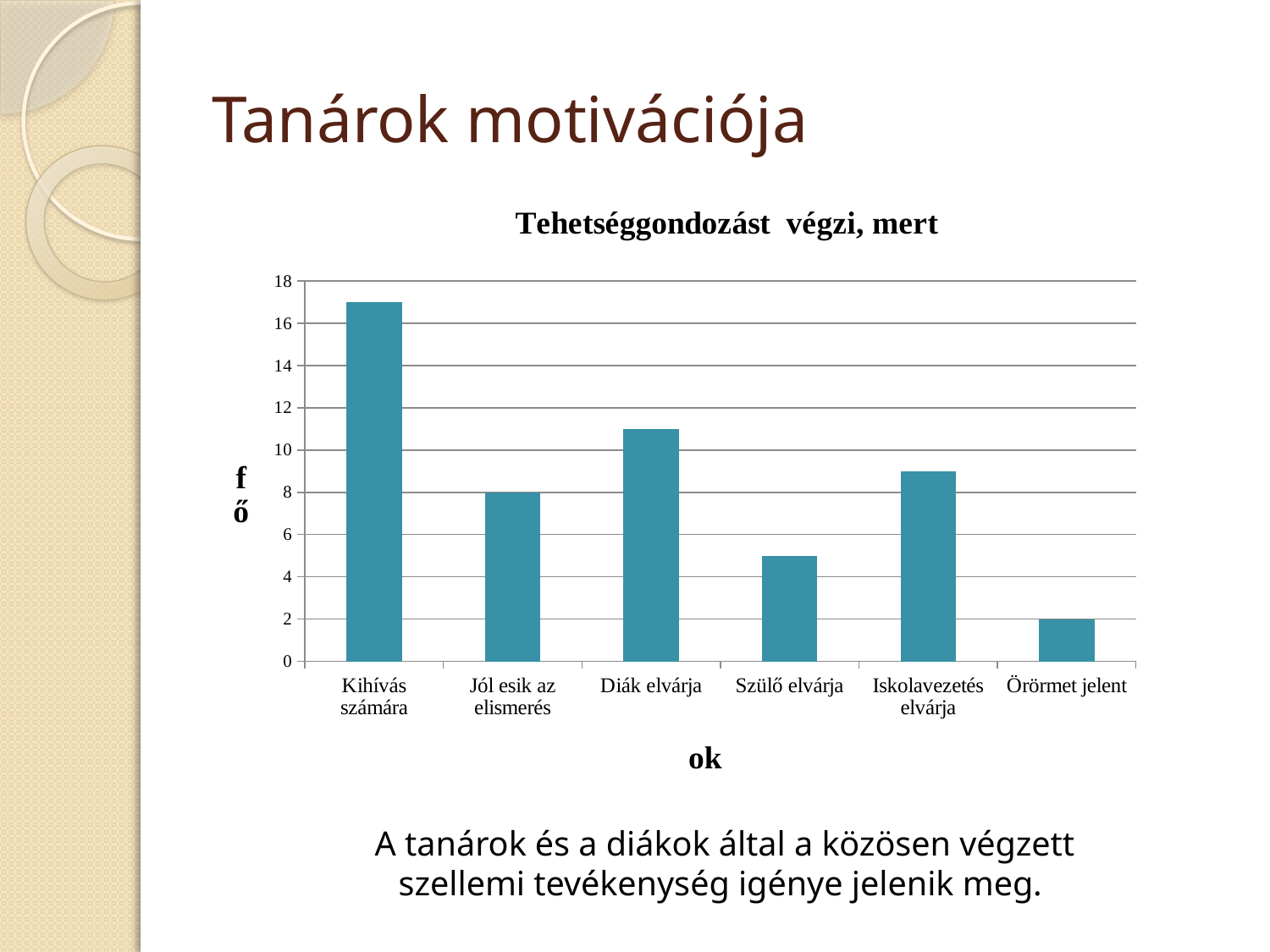
What is the value for Jól esik az elismerés? 8 What is the title of the chart? Tehetséggondozást végzi, mert What is the difference between the values for Jól esik az elismerés and Örörmet jelent? 6 Is the value for Kihívás számára greater or less than 16? greater Which is larger, the value for Diák elvárja or the value for Iskolavezetés elvárja? Diák elvárja Which category has the highest value in the chart? Kihívás számára What type of chart is shown on the slide? bar chart What is the value for Örörmet jelent? 2 Is the value for Szülő elvárja greater or less than 6? less What is the label of the y axis of the chart? fő How many categories are shown on the x axis of the chart? 6 Which category has the lowest value in the chart? Örörmet jelent